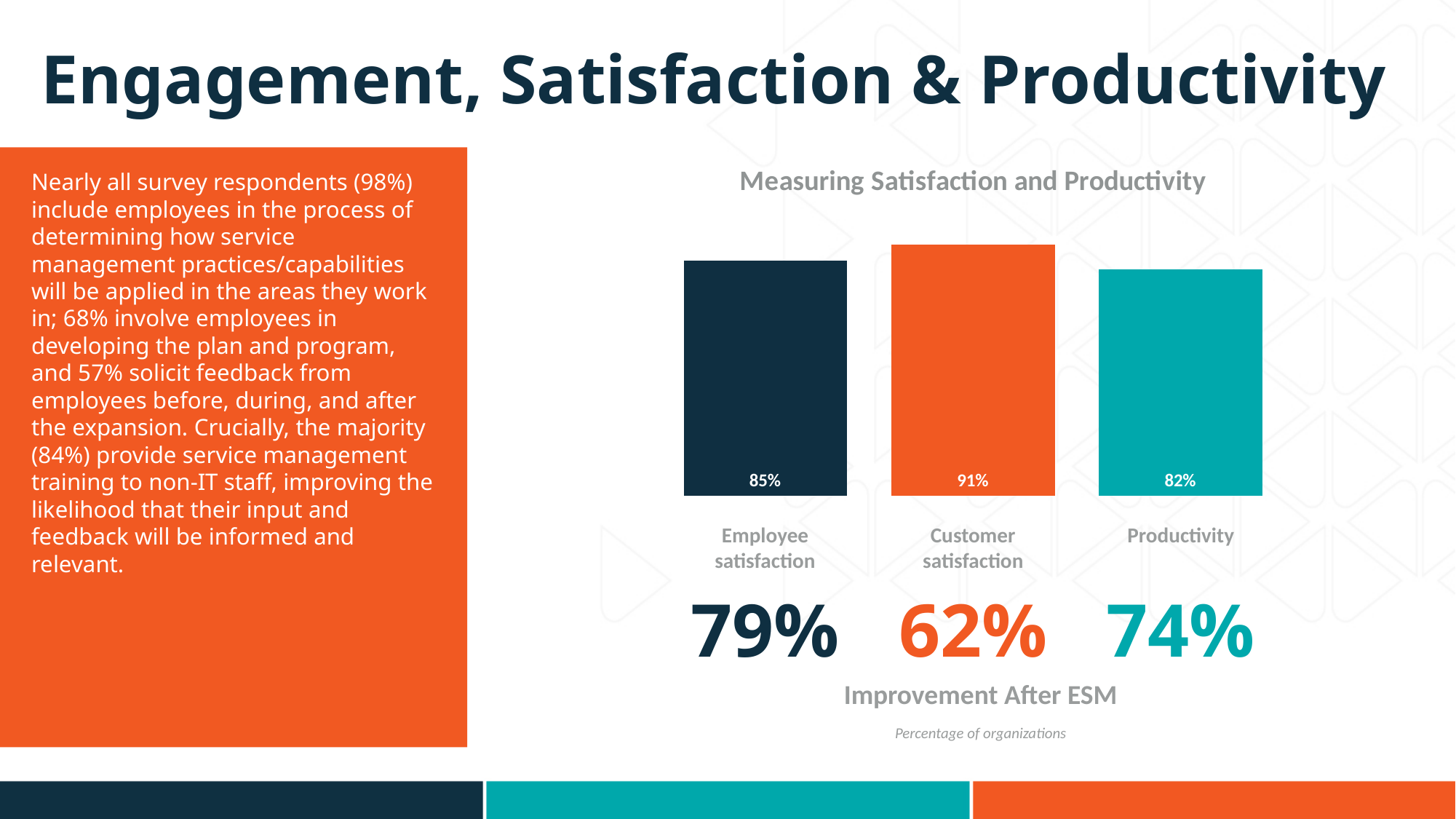
What is the value for Customer satisfaction in the Measuring Satisfaction and Productivity chart? 91% What is the value for Productivity in the Measuring Satisfaction and Productivity chart? 82% What is the value for Employee satisfaction in the Measuring Satisfaction and Productivity chart? 85% Which category has the lowest value in the Measuring Satisfaction and Productivity chart? Productivity What is the difference between the Customer satisfaction and Employee satisfaction values in the Measuring Satisfaction and Productivity chart? 6% How many bars are shown in the Measuring Satisfaction and Productivity chart? 3 What colour is the Customer satisfaction bar in the Measuring Satisfaction and Productivity chart? Orange What kind of chart is the Measuring Satisfaction and Productivity chart? Bar chart In the Measuring Satisfaction and Productivity chart, which is larger: Employee satisfaction or Productivity? Employee satisfaction What is the difference between the Employee satisfaction and Productivity values in the Measuring Satisfaction and Productivity chart? 3% Which category has the highest value in the Measuring Satisfaction and Productivity chart? Customer satisfaction What is the title of the chart on the slide? Measuring Satisfaction and Productivity